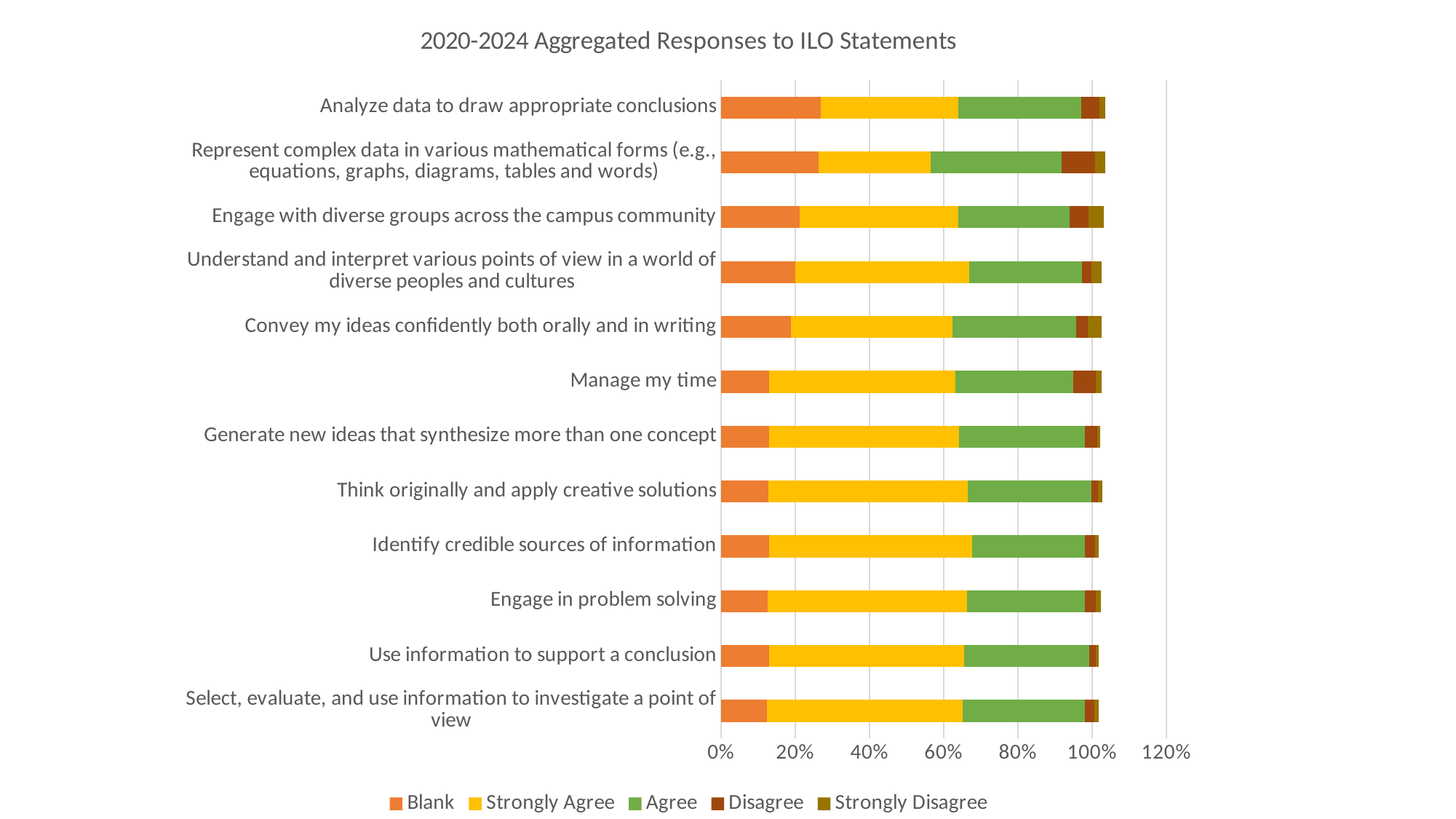
Which series is shown in yellow in the legend? Strongly Agree What type of chart is shown on the slide? Stacked bar chart Is the Blank share for "Engage in problem solving" greater or less than 20%? less Is the Blank share for "Analyze data to draw appropriate conclusions" greater or less than 20%? greater Which has the larger Blank share: "Analyze data to draw appropriate conclusions" or "Manage my time"? Analyze data to draw appropriate conclusions How many series does the legend list? 5 How many ILO statements (categories) are plotted in the chart? 12 Which has the larger Strongly Agree segment: "Represent complex data in various mathematical forms" or "Identify credible sources of information"? Identify credible sources of information Is the Blank share for "Manage my time" greater or less than 20%? less What is the title of the chart? 2020-2024 Aggregated Responses to ILO Statements Which statement has the largest Disagree segment? Represent complex data in various mathematical forms (e.g., equations, graphs, diagrams, tables and words)